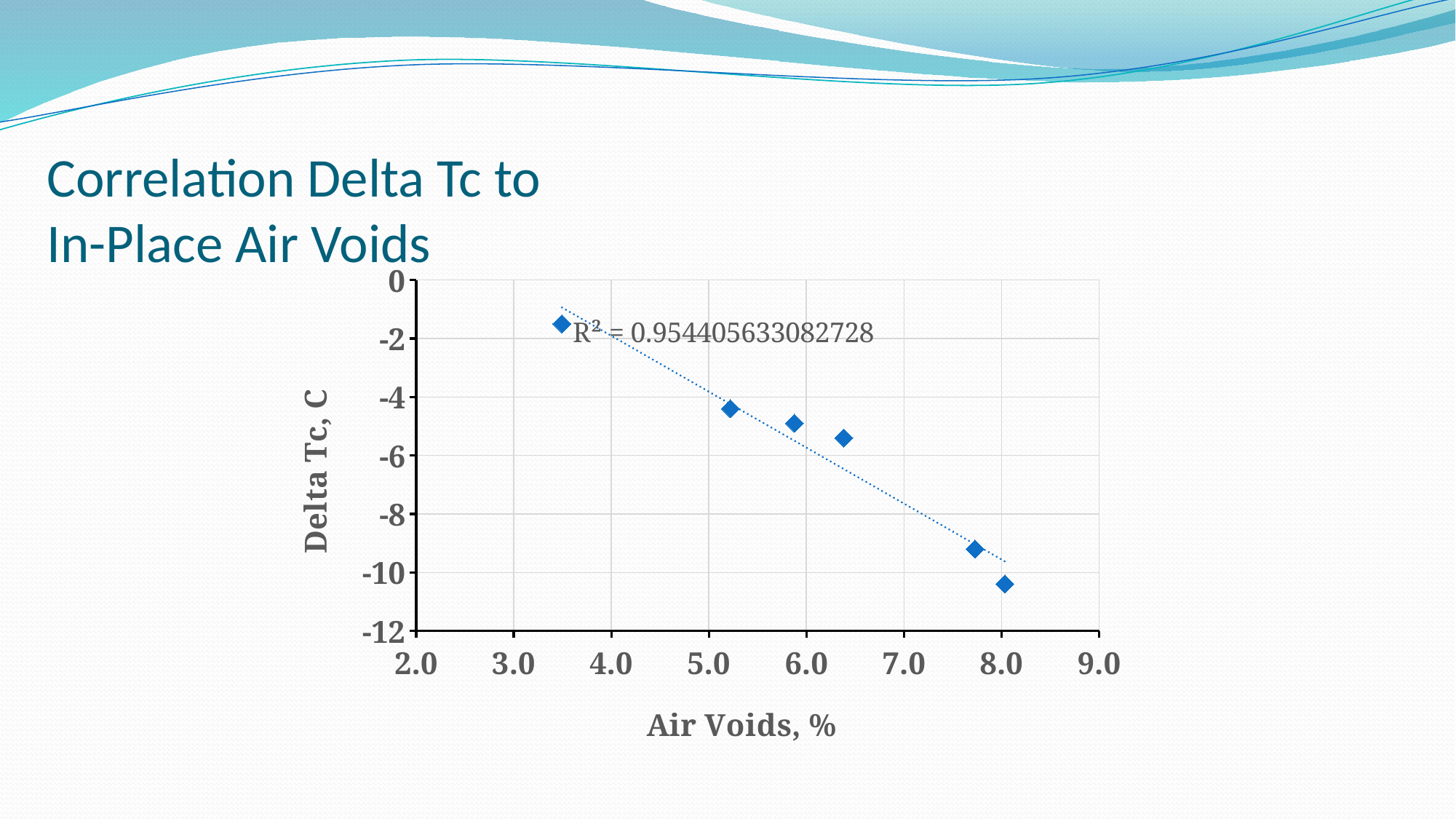
What kind of chart is shown on the slide? scatter chart Is the Delta Tc value for the data point at about 3.5% air voids greater or less than -2? greater How many data points are plotted on the chart? 6 Which data point has the highest Delta Tc value: the one at about 3.5% air voids or the one at about 8.0% air voids? the one at about 3.5% air voids What R² value is printed on the chart? R² = 0.954405633082728 Do the Delta Tc values rise or fall as Air Voids increase along the x axis? fall Is the Delta Tc value for the data point at about 7.7% air voids greater or less than -8? less What is the title of the x axis? Air Voids, % Is the Delta Tc value for the data point at about 8.0% air voids greater or less than -8? less